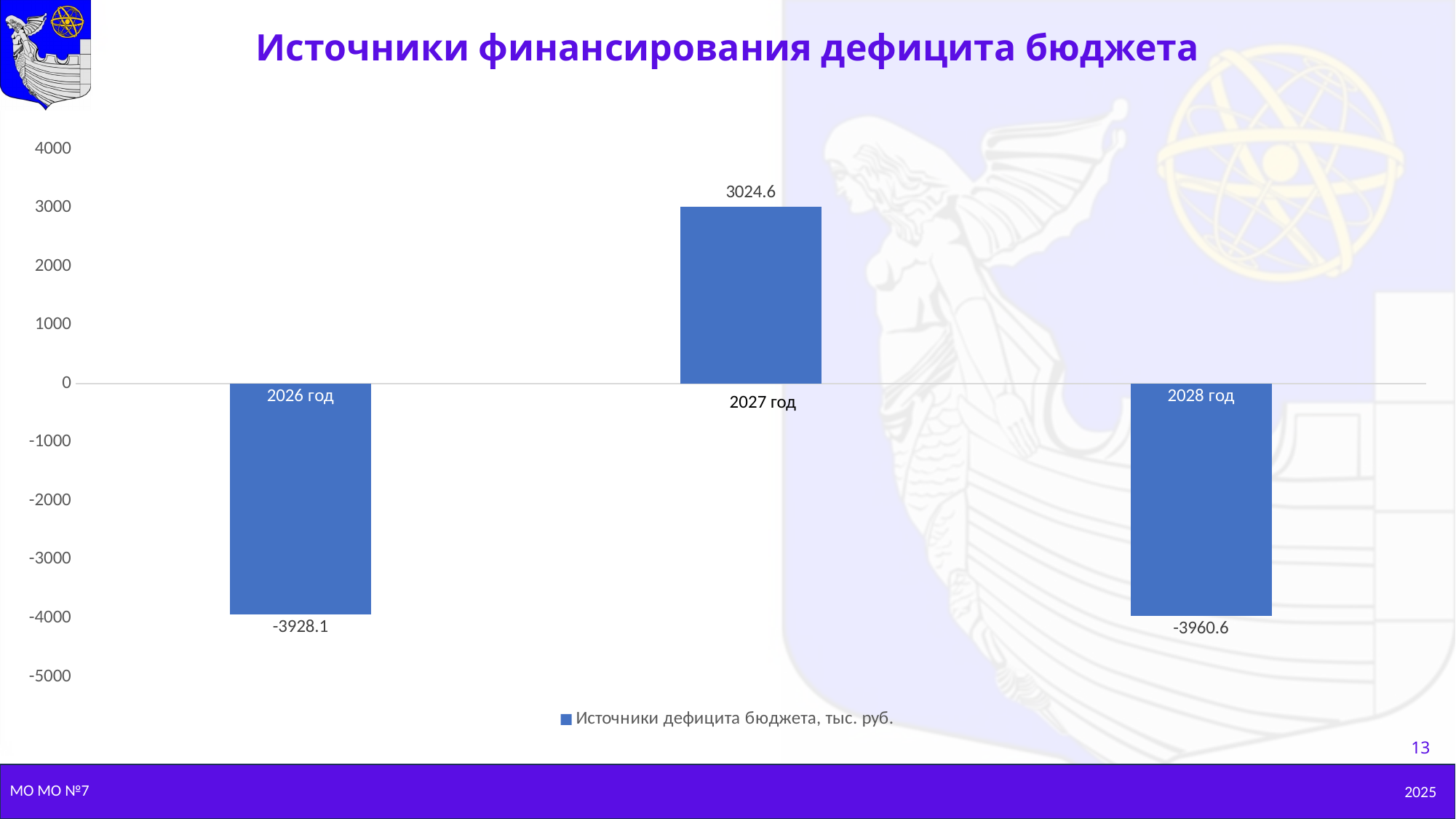
What is the value for 2027 год? 3024.6 Which year has the highest value? 2027 год What is the difference between the values for 2027 год and 2026 год? 6952.7 What is the value for 2026 год? -3928.1 What kind of chart is shown on the slide? bar chart Which year has the lowest value? 2028 год What is the value for 2028 год? -3960.6 Which is larger, the value for 2026 год or the value for 2028 год? 2026 год What is the legend entry of the chart? Источники дефицита бюджета, тыс. руб. Is the value for 2026 год greater or less than -3000? less How many years are shown on the chart? 3 What is the difference between the values for 2026 год and 2028 год? 32.5